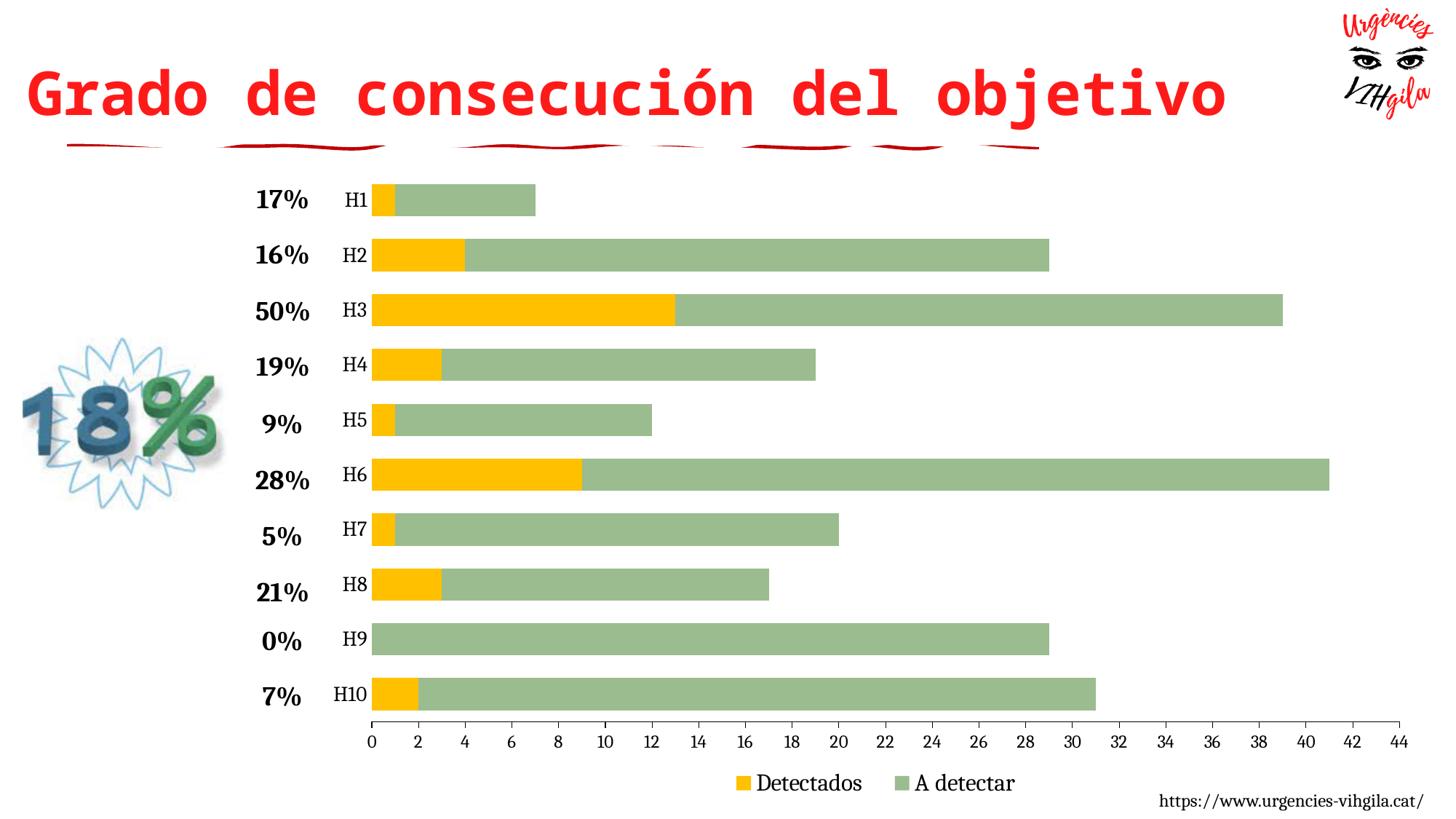
Is the total length of the H6 bar greater or less than 30? greater What percentage is printed next to H3? 50% What percentage is printed next to H9? 0% What kind of chart is shown on the slide? bar chart Which bar is longer in total, H6 or H1? H6 What are the two series named in the legend? Detectados and A detectar How many series does the legend list? 2 Which category has the lowest printed percentage? H9 Which category has the highest printed percentage? H3 How many categories (H1 to H10) does the chart show? 10 Is the total length of the H1 bar greater or less than 10? less What is the difference between the printed percentages for H3 and H6? 22 percentage points